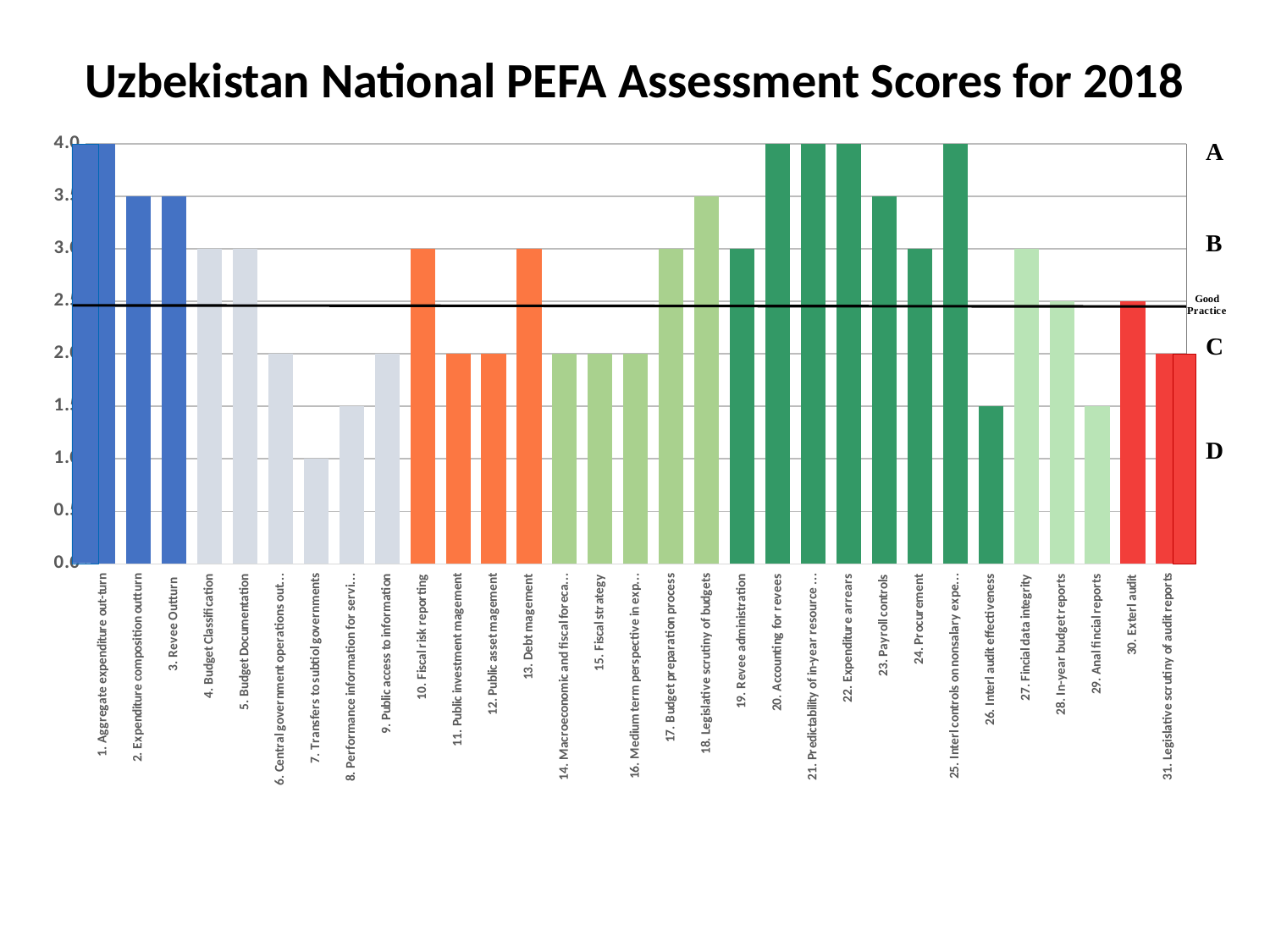
What is the difference between the scores for '24. Procurement' and '15. Fiscal strategy'? 1.0 What is the score for '10. Fiscal risk reporting'? 3.0 How many indicators (bars) are plotted in the chart? 31 What is the score for '4. Budget Classification'? 3.0 What kind of chart is shown on the slide? bar chart Is the score for '26. Internal audit effectiveness' greater or less than 2.0? less Which has the higher score: '18. Legislative scrutiny of budgets' or '15. Fiscal strategy'? 18. Legislative scrutiny of budgets Which indicator has the lowest score in the chart? 7. Transfers to subtiol governments What is the score for '23. Payroll controls'? 3.5 What is the score for '22. Expenditure arrears'? 4.0 What is the title of the chart? Uzbekistan National PEFA Assessment Scores for 2018